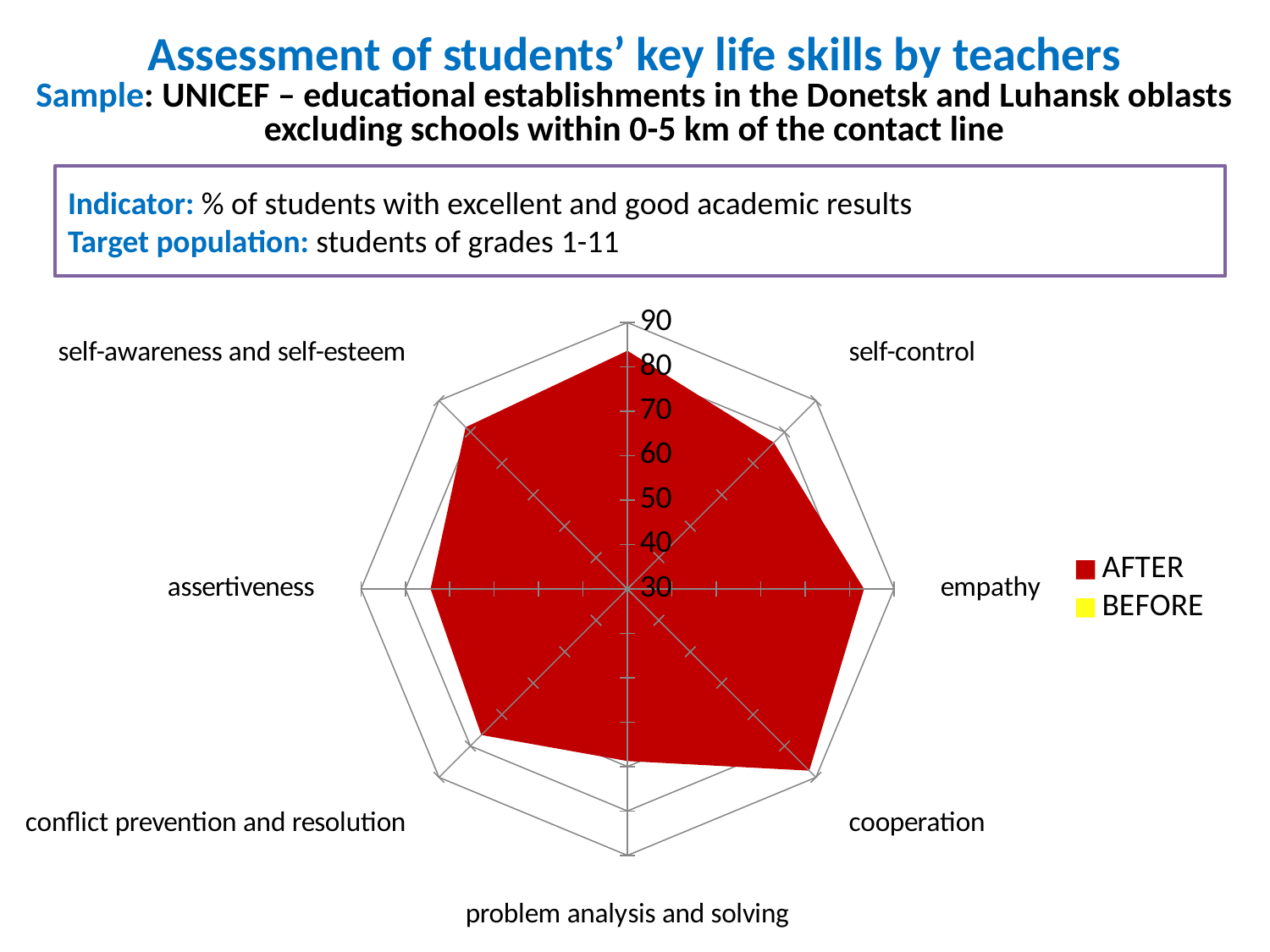
Is the AFTER value for cooperation greater or less than 80? greater Is the AFTER value for conflict prevention and resolution greater or less than 70? greater Which has the larger AFTER value, empathy or assertiveness? empathy How many series does the chart legend list? 2 Is the AFTER value for self-control greater or less than 90? less Which has the larger AFTER value, cooperation or problem analysis and solving? cooperation What colour represents the AFTER series in the chart? red What are the two series named in the chart legend? AFTER and BEFORE What kind of chart is shown on the slide? radar chart